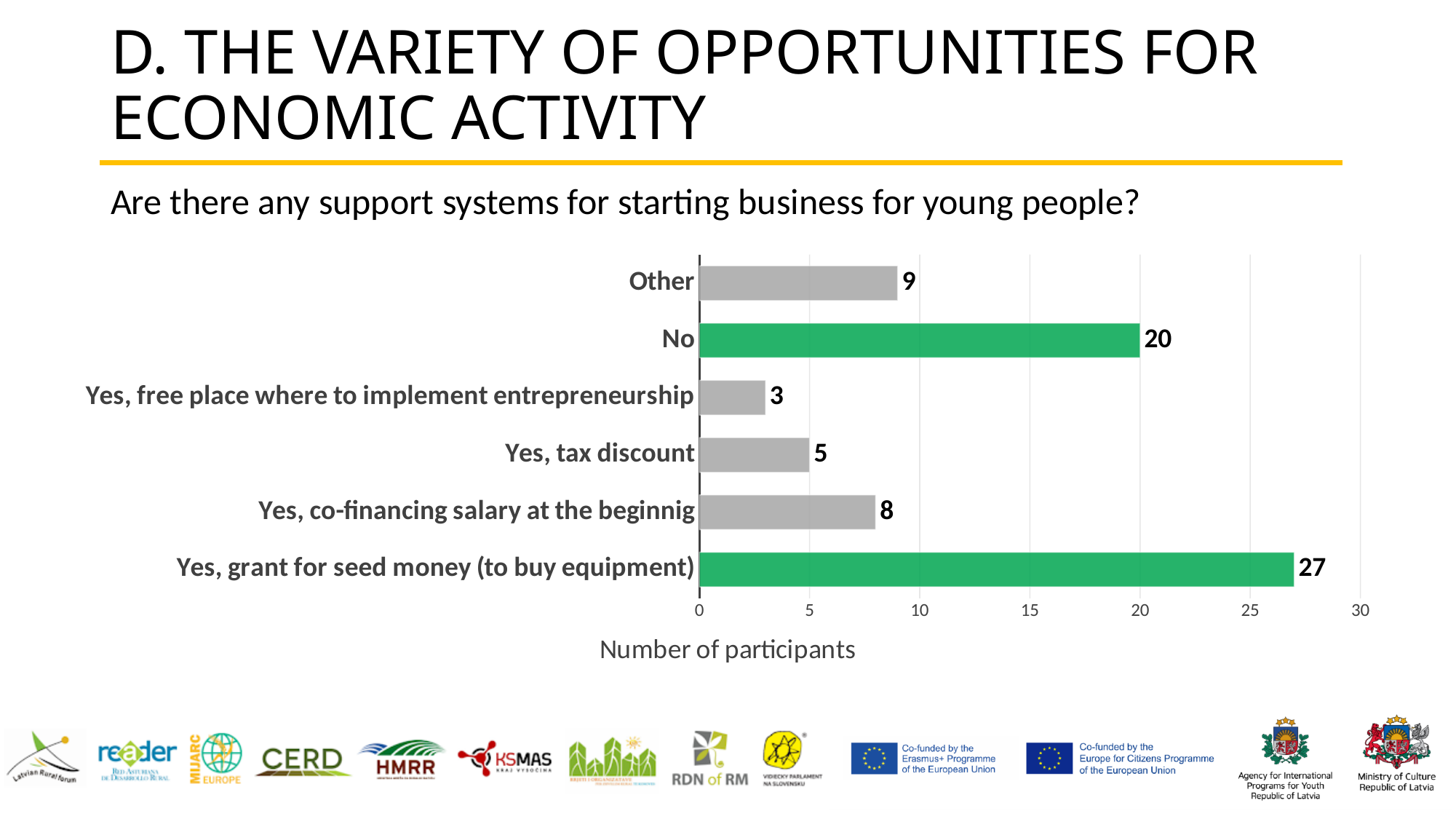
Is the value for "No" greater or less than 15? greater What kind of chart is shown on the slide? Bar chart How many participants answered "No"? 20 What is the value for "Yes, grant for seed money (to buy equipment)"? 27 How many categories are shown in the chart? 6 Which is larger: "Yes, co-financing salary at the beginnig" or "Yes, tax discount"? Yes, co-financing salary at the beginnig How many participants chose "Yes, tax discount"? 5 What is the difference between "Yes, grant for seed money (to buy equipment)" and "No"? 7 Which category has the highest number of participants? Yes, grant for seed money (to buy equipment) What is the value for "Other"? 9 What is the label of the horizontal axis? Number of participants Which category has the lowest number of participants? Yes, free place where to implement entrepreneurship